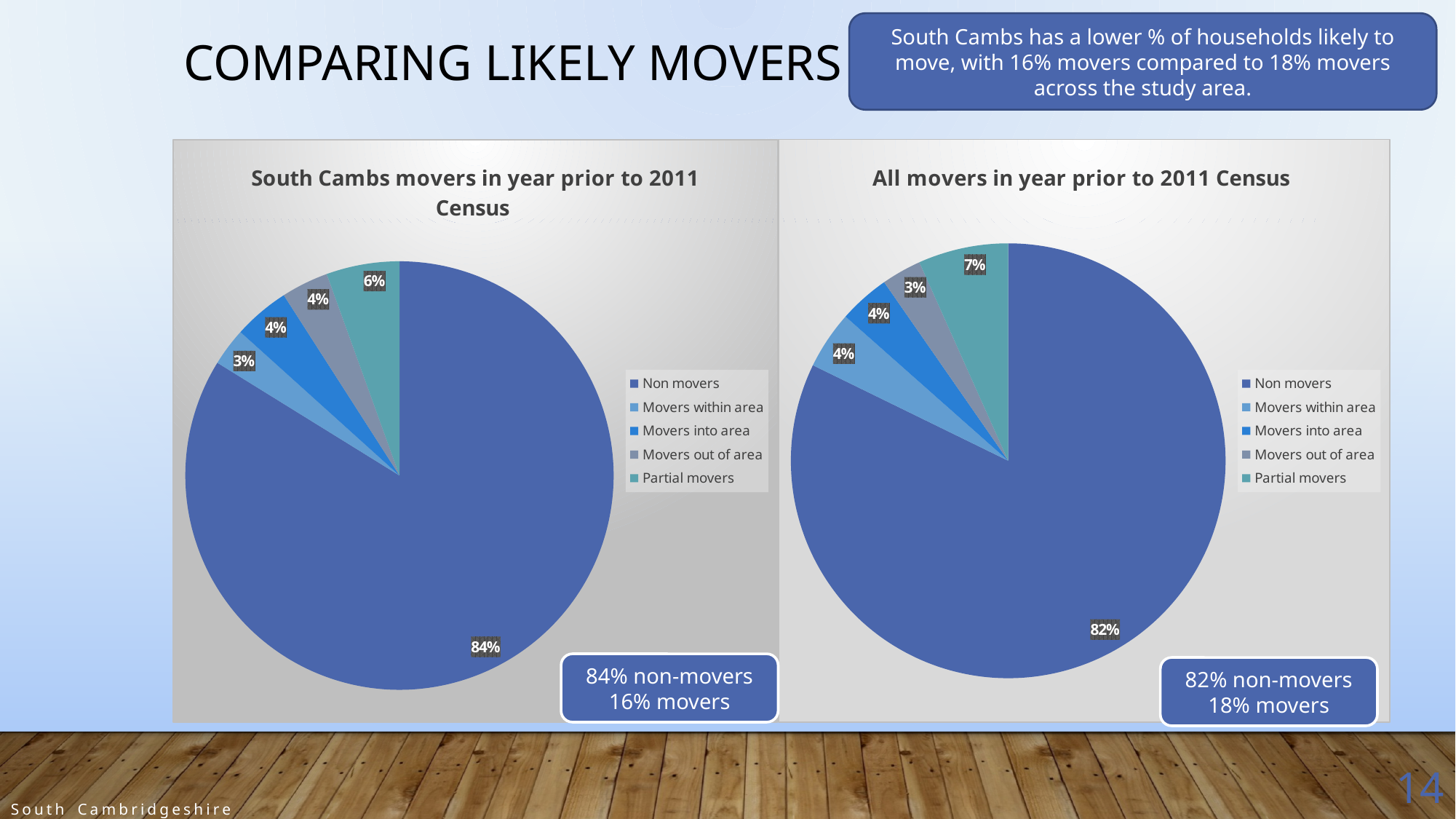
In the 'South Cambs movers in year prior to 2011 Census' chart, what share of the pie is Non movers? 84% In the 'South Cambs movers in year prior to 2011 Census' chart, which category has the largest slice? Non movers In the 'All movers in year prior to 2011 Census' chart, what share of the pie is Non movers? 82% In the 'South Cambs movers in year prior to 2011 Census' chart, which category has the smallest slice? Movers within area What is the difference between the Non movers share in the South Cambs chart and the Non movers share in the All movers chart? 2% In the 'All movers in year prior to 2011 Census' chart, what percentage is shown for Movers out of area? 3% In the 'South Cambs movers in year prior to 2011 Census' chart, what percentage is shown for Partial movers? 6% How many entries does the legend of the 'All movers in year prior to 2011 Census' chart list? 5 In the 'All movers in year prior to 2011 Census' chart, what percentage is shown for Partial movers? 7% What type of chart is the 'South Cambs movers in year prior to 2011 Census' chart? Pie chart In the 'South Cambs movers in year prior to 2011 Census' chart, what percentage is shown for Movers within area? 3% Which is larger: the Partial movers share in the South Cambs chart or the Partial movers share in the All movers chart? All movers chart